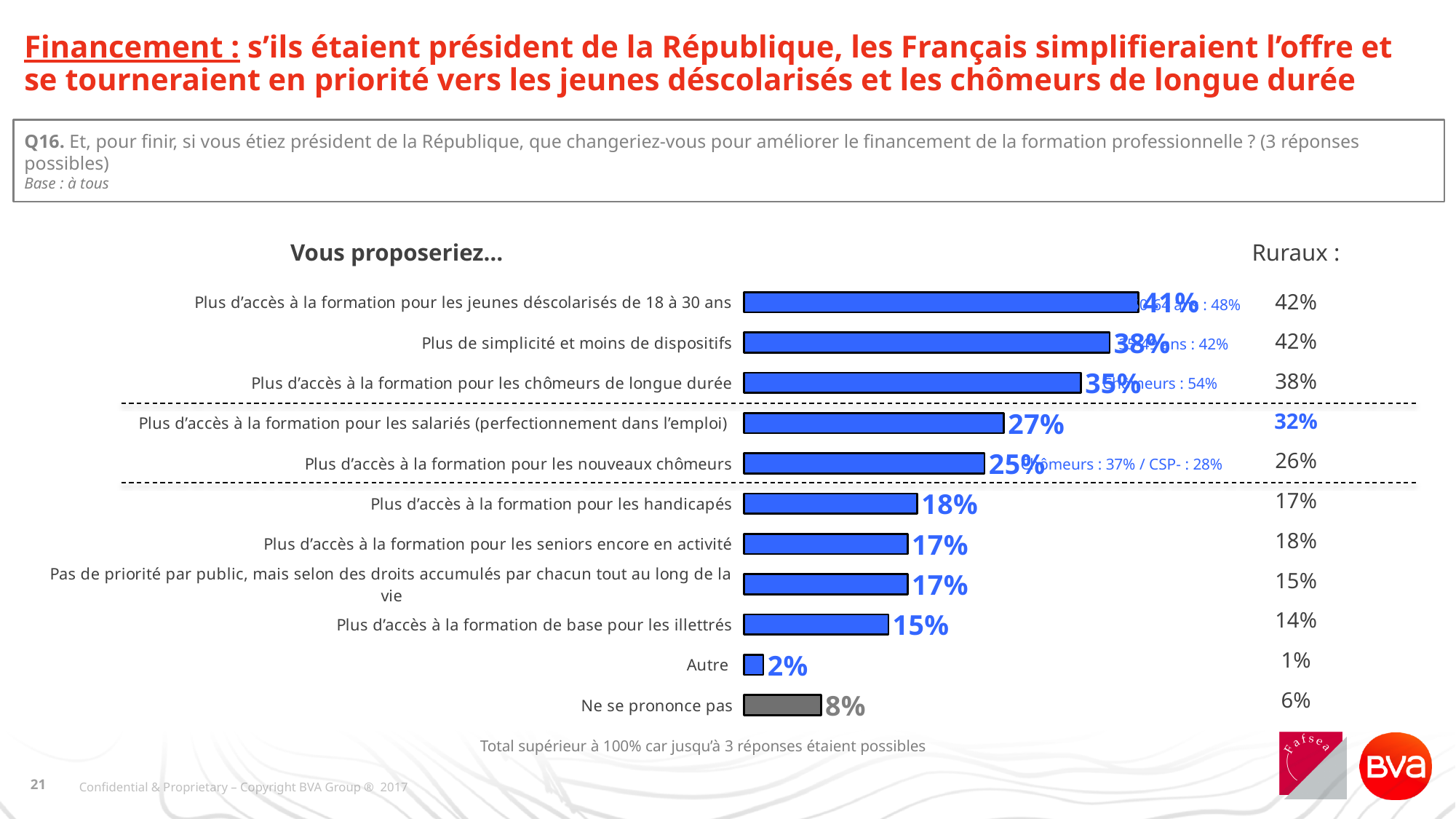
What percentage of respondents chose "Plus d'accès à la formation pour les jeunes déscolarisés de 18 à 30 ans"? 41% What is the difference between the values for "Plus d'accès à la formation pour les jeunes déscolarisés de 18 à 30 ans" and "Plus de simplicité et moins de dispositifs"? 3 percentage points What is the value shown for "Plus de simplicité et moins de dispositifs"? 38% Which bar is drawn in grey rather than blue? Ne se prononce pas What type of chart is shown on the slide? Bar chart What is the value shown for "Ne se prononce pas"? 8% How many categories are plotted in the chart? 11 Which is larger: the value for "Plus d'accès à la formation pour les handicapés" or for "Plus d'accès à la formation de base pour les illettrés"? Plus d'accès à la formation pour les handicapés Which category has the lowest value in the chart? Autre Which category has the highest value in the chart? Plus d'accès à la formation pour les jeunes déscolarisés de 18 à 30 ans What is the difference between the values for "Plus d'accès à la formation pour les chômeurs de longue durée" and "Plus d'accès à la formation pour les nouveaux chômeurs"? 10 percentage points What is the value shown for "Plus d'accès à la formation pour les salariés (perfectionnement dans l'emploi)"? 27%